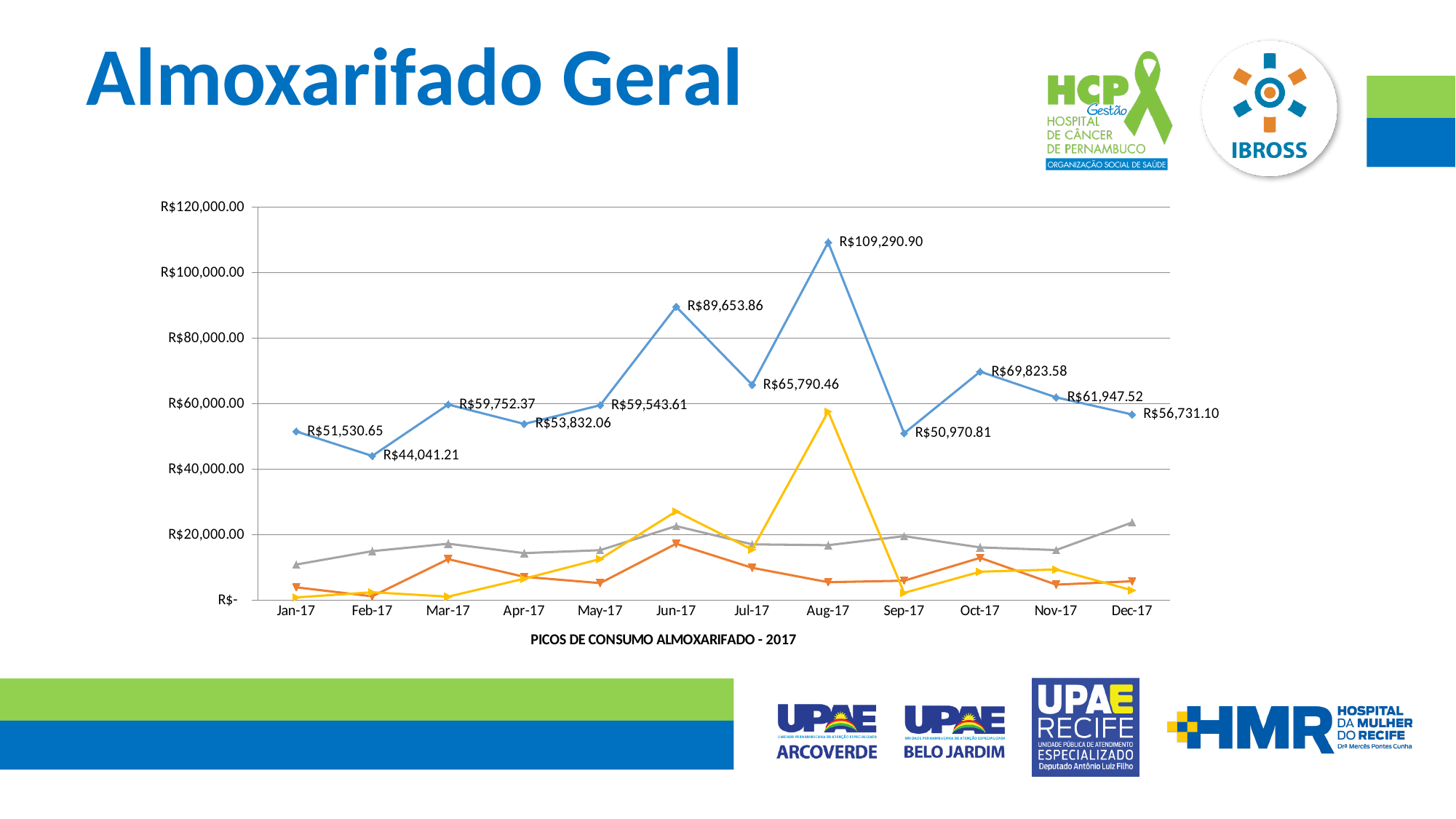
What is the text shown below the x axis of the chart? PICOS DE CONSUMO ALMOXARIFADO - 2017 Is the value of the yellow line for Aug-17 greater or less than R$40,000.00? greater Which is larger for the blue line, the value for Oct-17 or the value for Nov-17? Oct-17 What is the difference between the blue line's values for Aug-17 and Jun-17? R$19,637.04 In which month does the blue line reach its lowest value? Feb-17 What is the value of the blue line for Feb-17? R$44,041.21 How many months are plotted along the x axis? 12 In which month does the blue line reach its highest value? Aug-17 What is the value of the blue line for Dec-17? R$56,731.10 What kind of chart is shown on the slide? line chart What is the value of the blue line for Aug-17? R$109,290.90 What is the value of the blue line for Jun-17? R$89,653.86